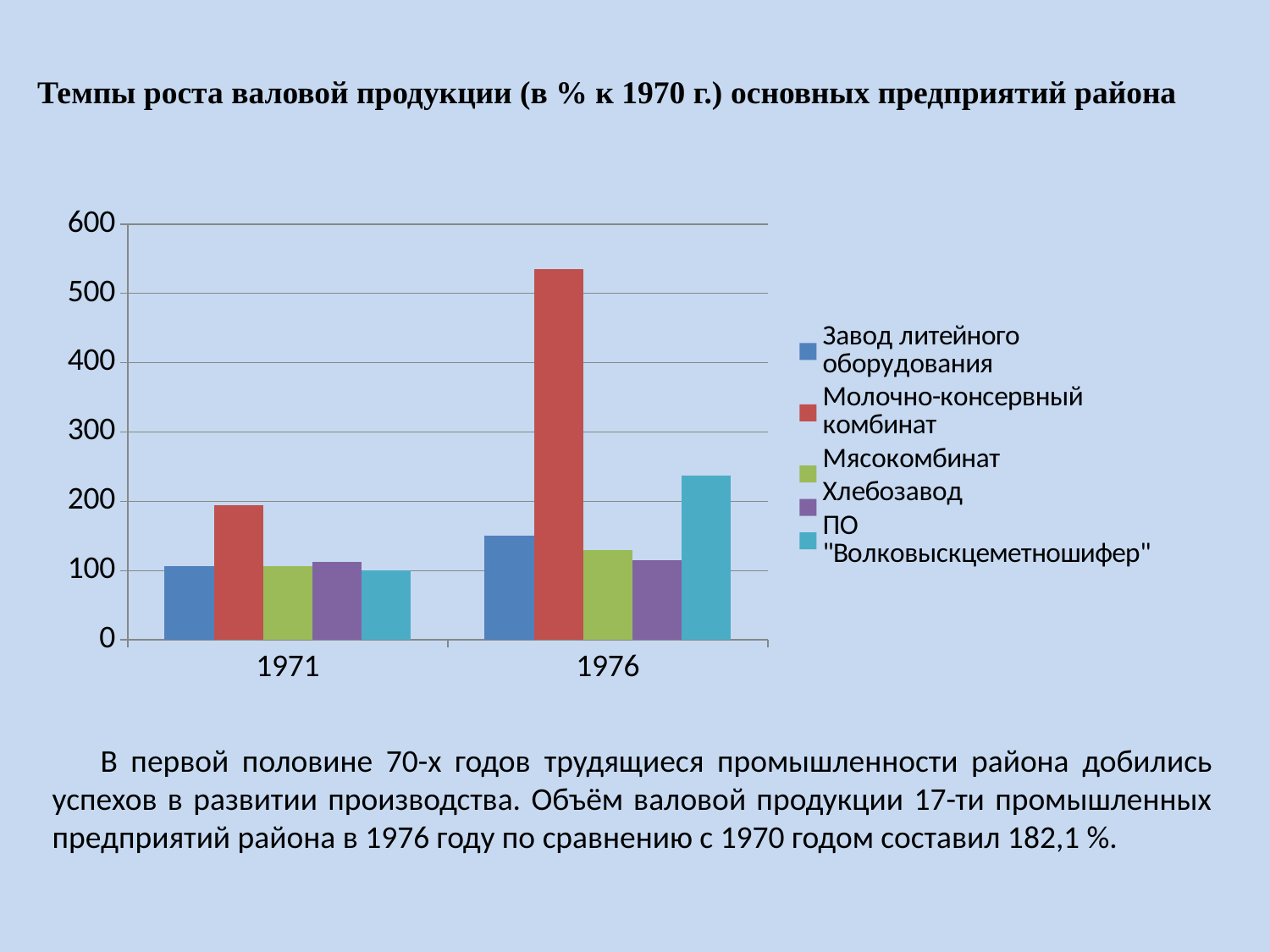
What kind of chart is shown on the slide? bar chart Does the value for Молочно-консервный комбинат rise or fall from 1971 to 1976? rise Is the value for ПО "Волковыскцеметношифер" in 1976 greater or less than 200? greater Which enterprise has the highest value in 1976? Молочно-консервный комбинат Is the value for Молочно-консервный комбинат in 1976 greater or less than 500? greater What is the title of the chart on the slide? Темпы роста валовой продукции (в % к 1970 г.) основных предприятий района How many year categories are shown on the x axis of the chart? 2 Is the value for Мясокомбинат in 1976 greater or less than 200? less Which is larger in 1976: the value for Молочно-консервный комбинат or the value for ПО "Волковыскцеметношифер"? Молочно-консервный комбинат How many series does the chart legend list? 5 Which enterprise has the highest value in 1971? Молочно-консервный комбинат